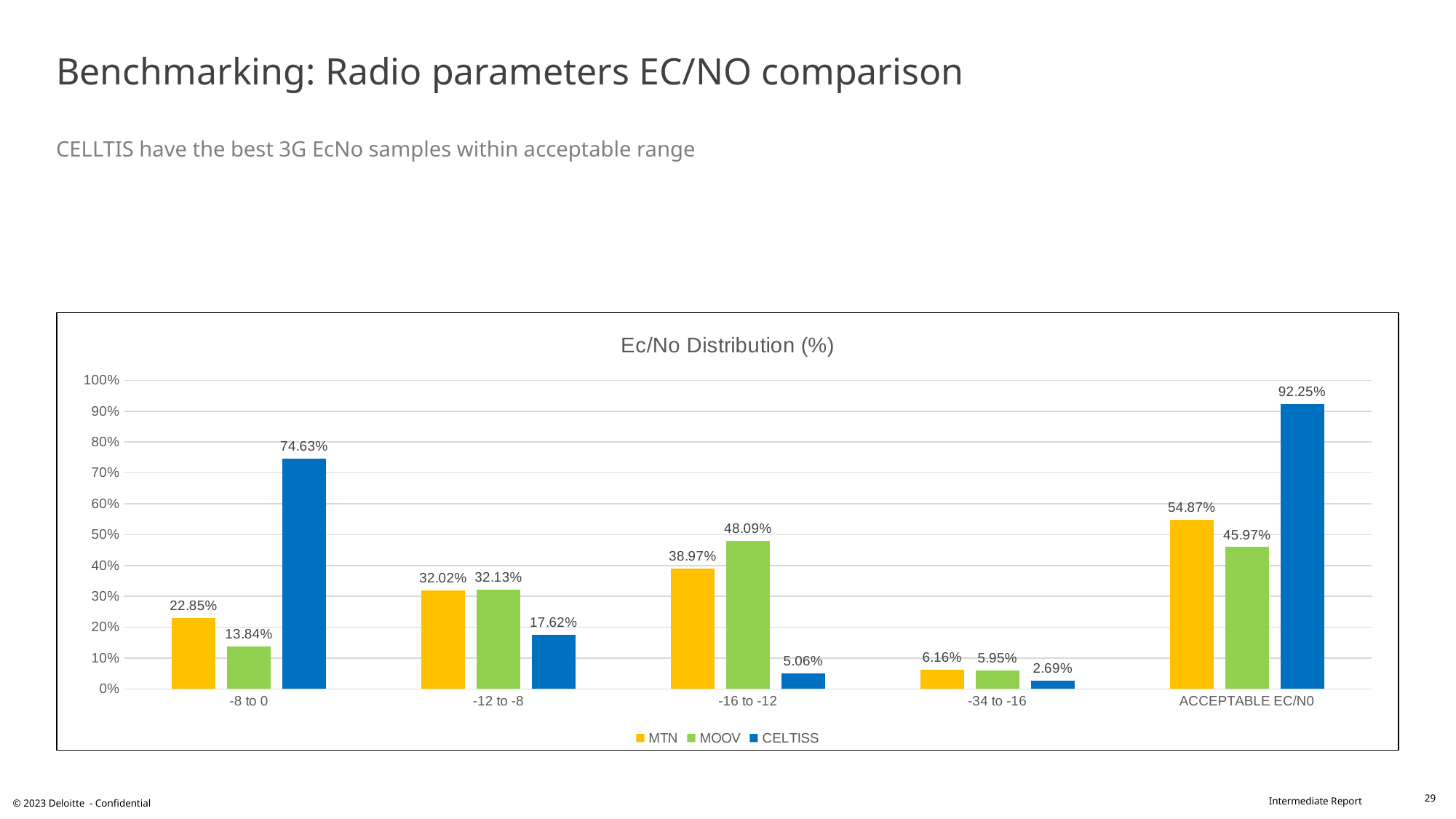
What is the title of the chart? Ec/No Distribution (%) What is the value for CELTISS in the ACCEPTABLE EC/N0 category? 92.25% Is the value for CELTISS in the -12 to -8 category greater or less than 20%? less What is the difference between MTN and MOOV in the ACCEPTABLE EC/N0 category? 8.90% Which is larger in the -16 to -12 category, MTN or MOOV? MOOV How many categories are shown on the x axis? 5 What is the value for MOOV in the -8 to 0 category? 13.84% How many series does the legend list? 3 Which series has the highest value in the -8 to 0 category? CELTISS What is the value for MTN in the -16 to -12 category? 38.97% Which series has the lowest value in the -34 to -16 category? CELTISS What kind of chart is shown on the slide? bar chart